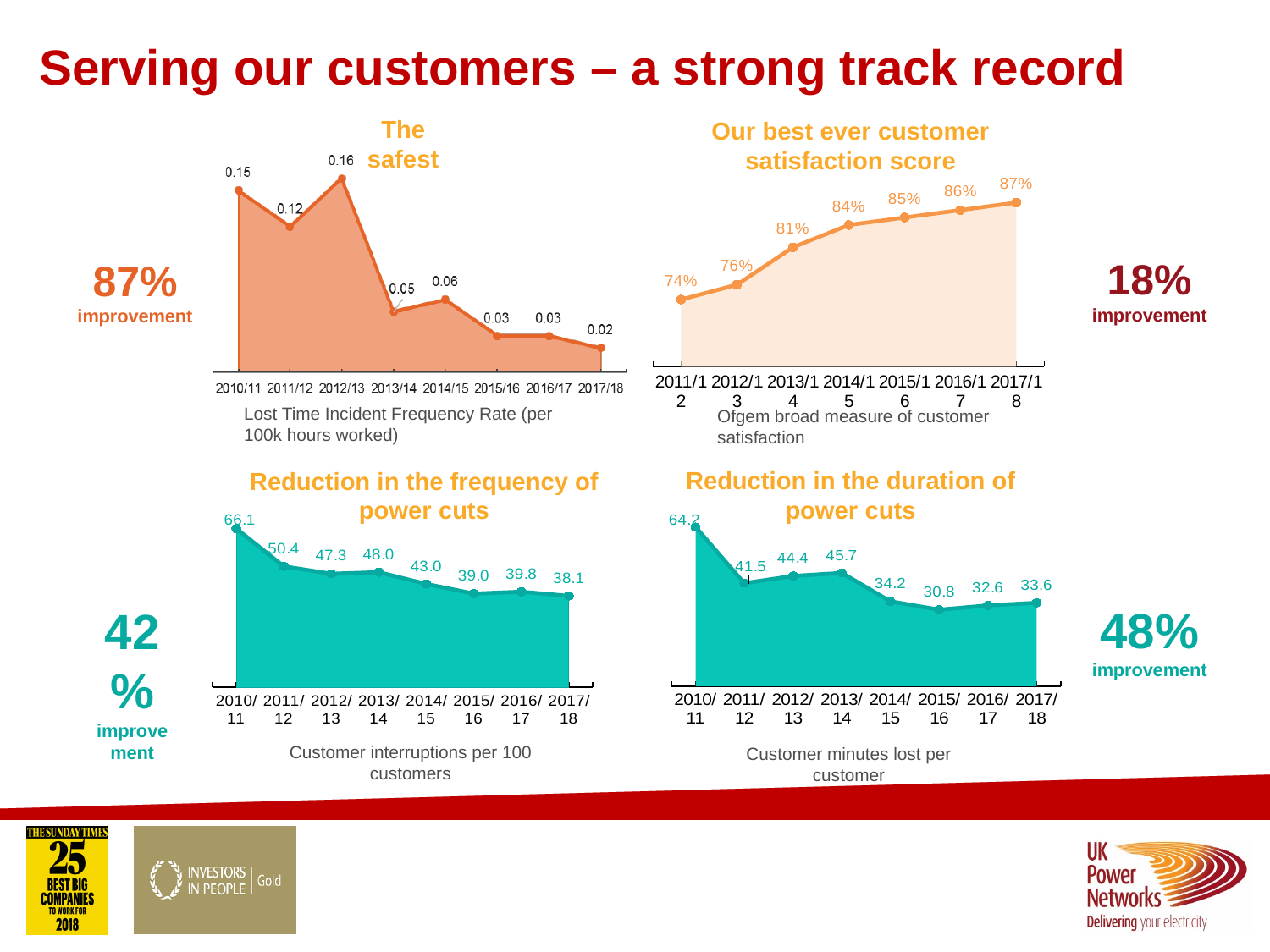
What kind of chart is the 'Reduction in the duration of power cuts' chart? area chart In the 'The safest' chart, what is the Lost Time Incident Frequency Rate for 2012/13? 0.16 In the 'Reduction in the frequency of power cuts' chart, which is larger, the value for 2015/16 or 2016/17? 2016/17 In the 'Reduction in the frequency of power cuts' chart, what is the value for 2014/15? 43.0 In the 'Reduction in the duration of power cuts' chart, what is the value for 2015/16? 30.8 In the 'Our best ever customer satisfaction score' chart, what is the difference between the 2017/18 and 2011/12 scores? 13% In the 'Our best ever customer satisfaction score' chart, do the values rise or fall from 2011/12 to 2017/18? rise In the 'The safest' chart, how many years are plotted? 8 In the 'Reduction in the duration of power cuts' chart, what is the difference between the 2010/11 and 2017/18 values? 30.6 In the 'The safest' chart, which year has the lowest Lost Time Incident Frequency Rate? 2017/18 In the 'Reduction in the frequency of power cuts' chart, which year has the highest value? 2010/11 In the 'Our best ever customer satisfaction score' chart, what is the satisfaction score for 2013/14? 81%